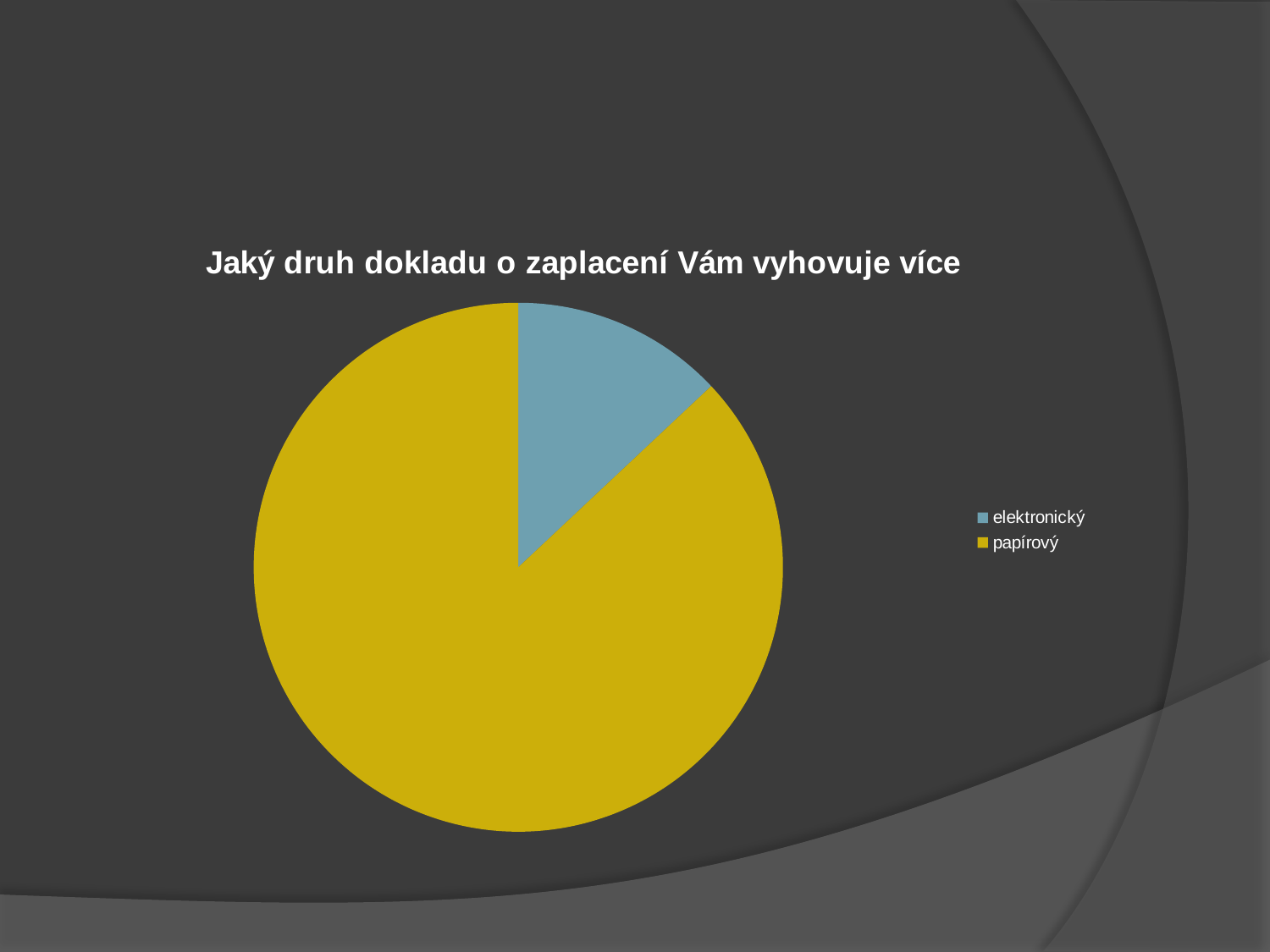
Which category has the smallest slice of the pie? elektronický How many entries does the legend list? 2 How many slices does the pie chart have? 2 What kind of chart is shown on the slide? pie chart Which colour represents the papírový category? yellow Which slice is larger, elektronický or papírový? papírový Which category has the largest slice of the pie? papírový What is the title of the chart? Jaký druh dokladu o zaplacení Vám vyhovuje více